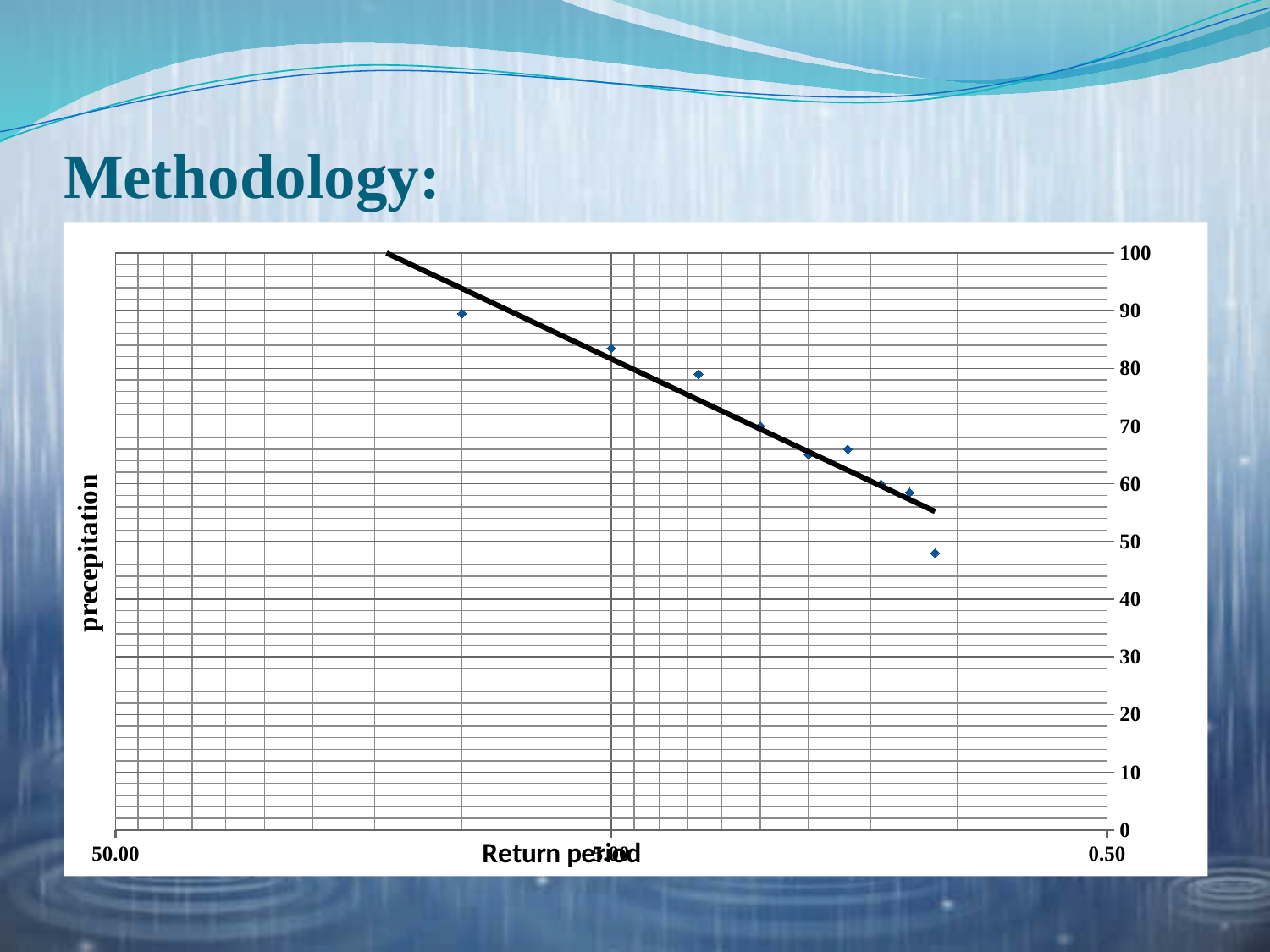
Is the leftmost plotted point greater or less than 80 on the precipitation axis? greater What is the highest value shown on the vertical axis? 100 What is the title of the horizontal axis? Return period Do the plotted precipitation values rise or fall moving from left to right along the x axis? fall Is the lowest plotted precipitation value greater or less than 50? less What kind of chart is shown on the slide? scatter chart How many data points are plotted on the chart? 9 Is the highest plotted precipitation value greater or less than 80? greater